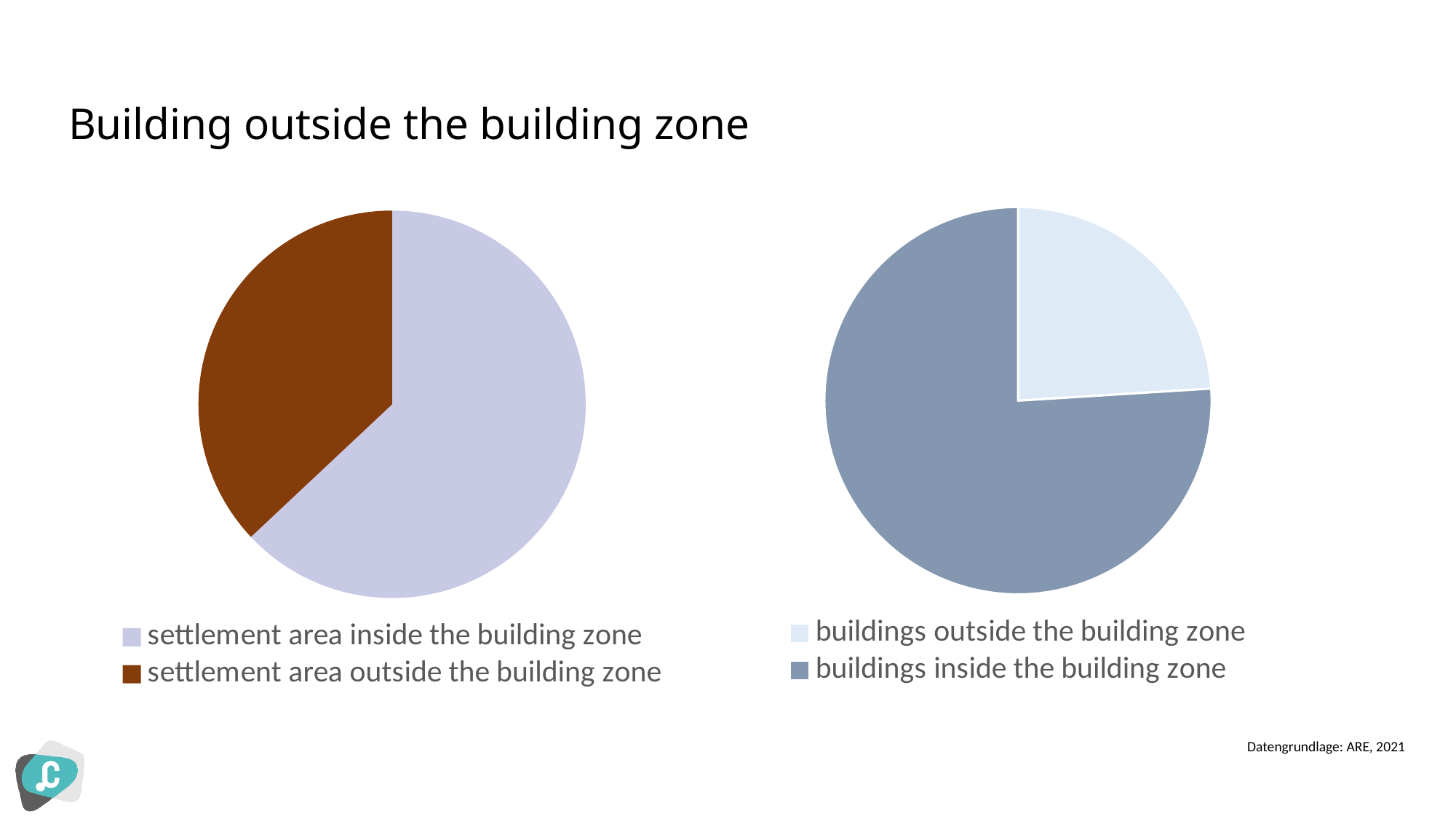
In the left pie chart, which category has the largest slice? settlement area inside the building zone In the left pie chart, which category has the smallest slice? settlement area outside the building zone In the right pie chart, which category has the largest slice? buildings inside the building zone In the right pie chart, which category has the smallest slice? buildings outside the building zone In the left pie chart, what colour is the slice for settlement area outside the building zone? brown In the right pie chart, which is larger: buildings outside the building zone or buildings inside the building zone? buildings inside the building zone What kind of chart is the left chart on the slide? pie chart How many entries does the legend of the right pie chart list? 2 How many slices does the left pie chart have? 2 What is the title of the slide containing the two pie charts? Building outside the building zone What kind of chart is the right chart on the slide? pie chart In the left pie chart, which is larger: settlement area inside the building zone or settlement area outside the building zone? settlement area inside the building zone